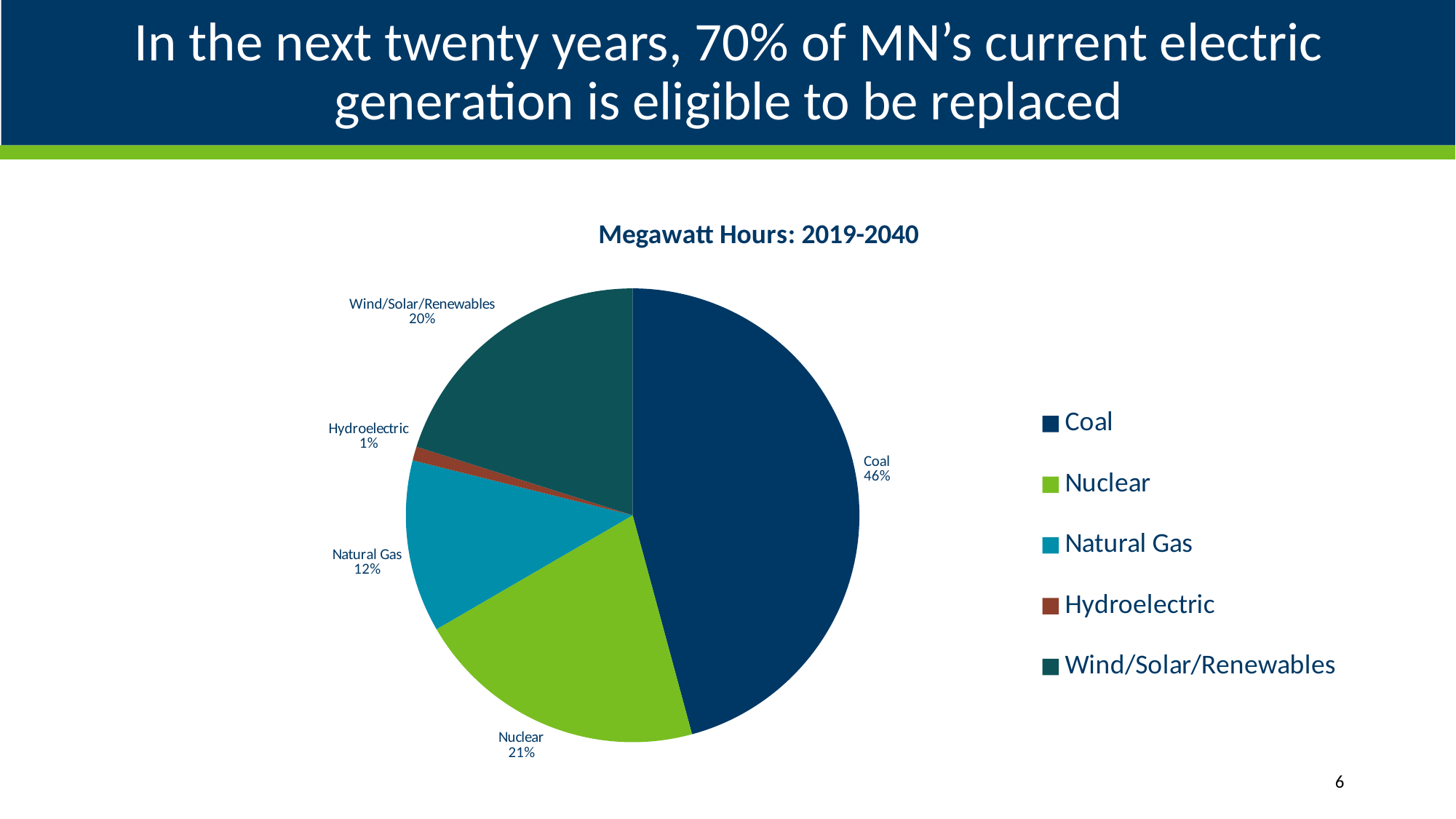
What share of the pie does Coal represent? 46% What kind of chart is shown on the slide? Pie chart What is the difference in percentage points between the Coal and Nuclear slices? 25 How many categories are shown in the pie chart? 5 Which slice is larger, Nuclear or Wind/Solar/Renewables? Nuclear What share of the pie does Wind/Solar/Renewables represent? 20% What share of the pie does Hydroelectric represent? 1% Which category has the smallest slice of the pie? Hydroelectric What is the title of the chart? Megawatt Hours: 2019-2040 Which category has the largest slice of the pie? Coal